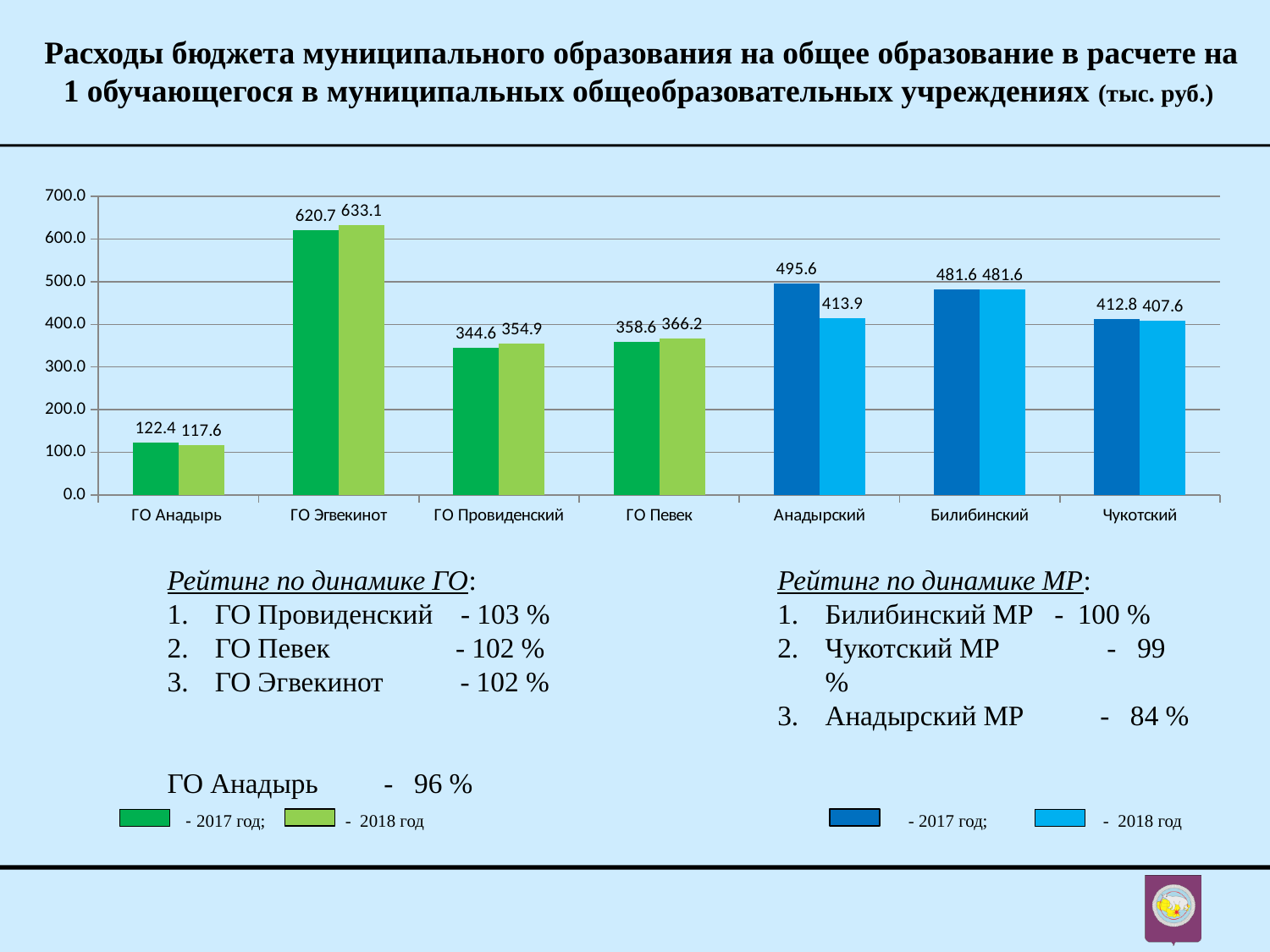
What is the 2018 value for ГО Провиденский? 354.9 Which municipality has the highest 2018 value? ГО Эгвекинот Which municipality has the lowest 2017 value? ГО Анадырь How many municipalities are shown on the x axis of the chart? 7 Which is larger for Чукотский: the 2017 value or the 2018 value? 2017 value What is the difference between the 2018 values for ГО Певек and ГО Провиденский? 11.3 What is the 2017 value for ГО Эгвекинот? 620.7 What is the 2018 value for Анадырский? 413.9 Is the 2017 value for Билибинский greater or less than 400.0? greater What is the 2017 value for Билибинский? 481.6 What type of chart is shown on the slide? bar chart What is the difference between the 2017 and 2018 values for Анадырский? 81.7